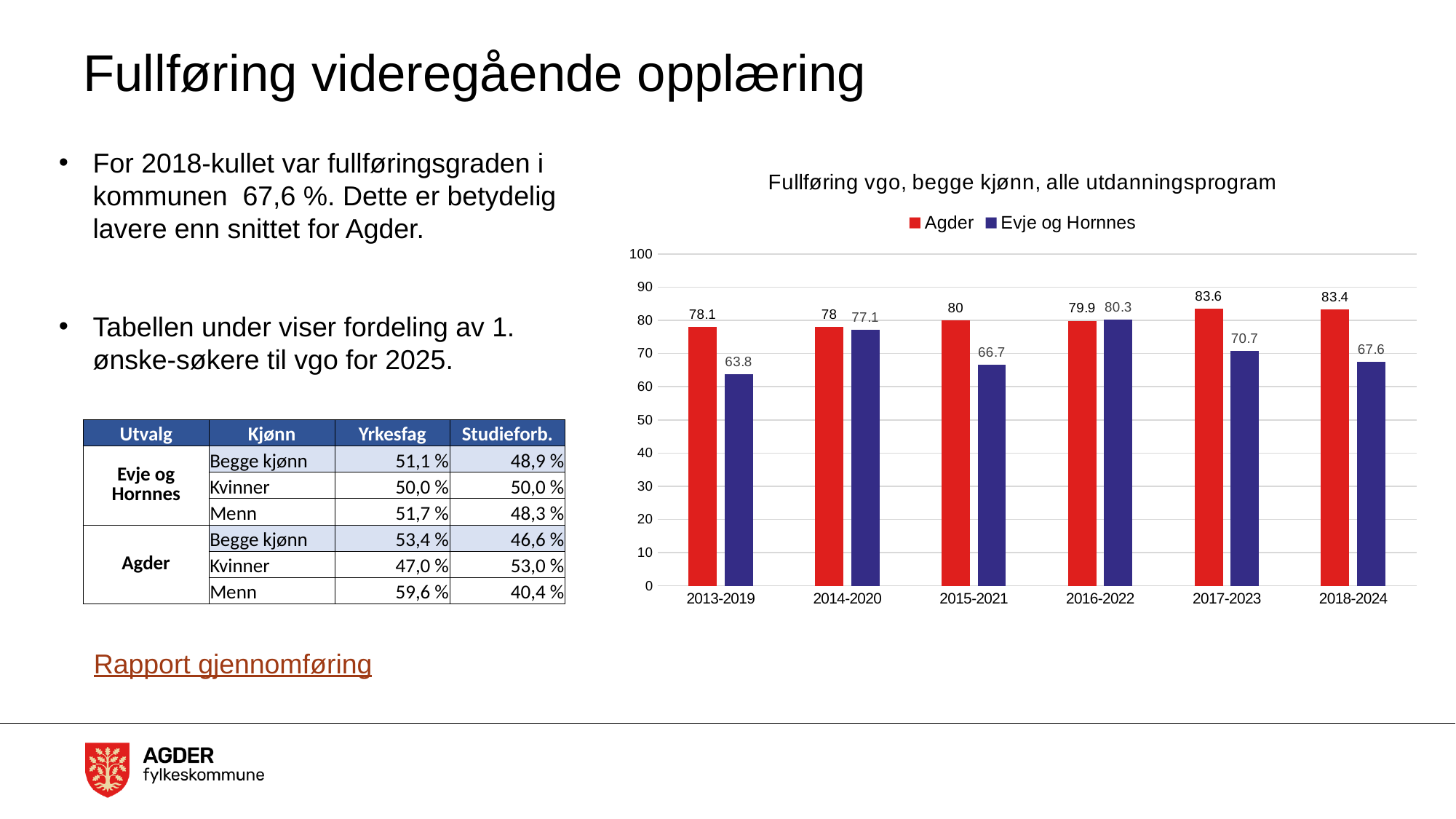
Which is larger in 2016-2022, Agder or Evje og Hornnes? Evje og Hornnes What kind of chart is shown? bar chart Is the value for Evje og Hornnes in 2013-2019 greater or less than 70? less How many series does the legend list? 2 What is the value for Agder in 2013-2019? 78.1 What is the value for Evje og Hornnes in 2016-2022? 80.3 How many periods are shown on the x axis? 6 What is the value for Evje og Hornnes in 2018-2024? 67.6 In which period is the Evje og Hornnes value lowest? 2013-2019 What is the title of the chart? Fullføring vgo, begge kjønn, alle utdanningsprogram What is the difference between Agder and Evje og Hornnes in 2018-2024? 15.8 In which period is the Agder value highest? 2017-2023